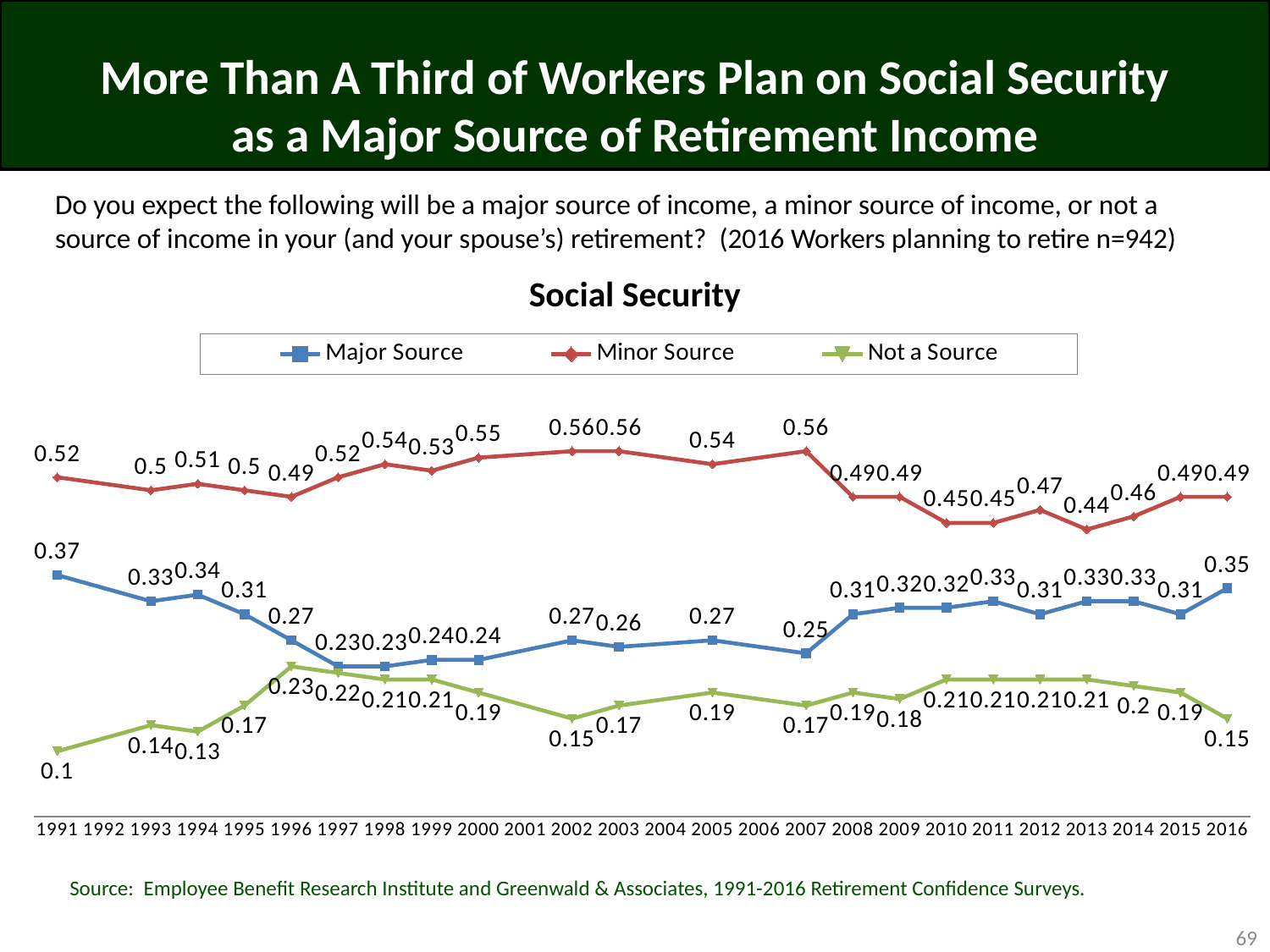
What kind of chart is shown on the slide? line chart What is the value for Minor Source in 1991? 0.52 How many series does the legend list? 3 What is the difference between the Major Source values in 1991 and 2016? 0.02 In which year is the Not a Source series at its lowest value? 1991 In 2016, which is larger: the Major Source value or the Not a Source value? Major Source What is the value for Not a Source in 1996? 0.23 What is the value for Not a Source in 2016? 0.15 Does the Major Source series rise or fall from 1991 to 1997? fall What is the difference between the Minor Source values in 2007 and 2008? 0.07 What is the value for Major Source in 2016? 0.35 What is the highest value shown for the Minor Source series? 0.56